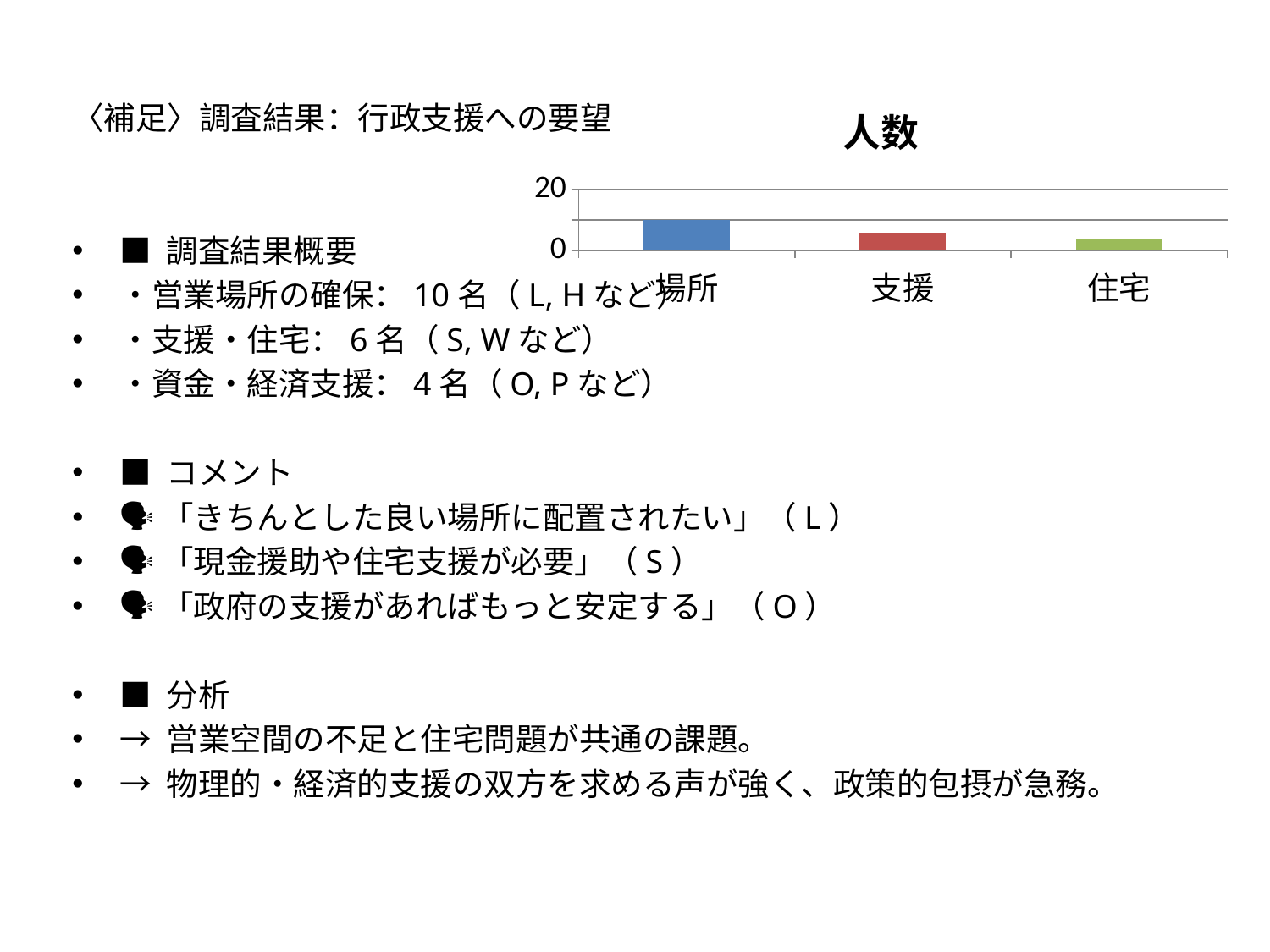
What kind of chart is shown on the slide? bar chart What colour is the bar for 場所? blue What is the title of the chart? 人数 Is the value for 場所 greater or less than 20? less How many categories are plotted in the chart? 3 Which category has the lowest value in the chart? 住宅 Do the values rise or fall from left to right across the categories? fall Is the value for 住宅 greater or less than 20? less Which is larger, the value for 場所 or the value for 支援? 場所 Which is larger, the value for 支援 or the value for 住宅? 支援 Which category has the highest value in the chart? 場所